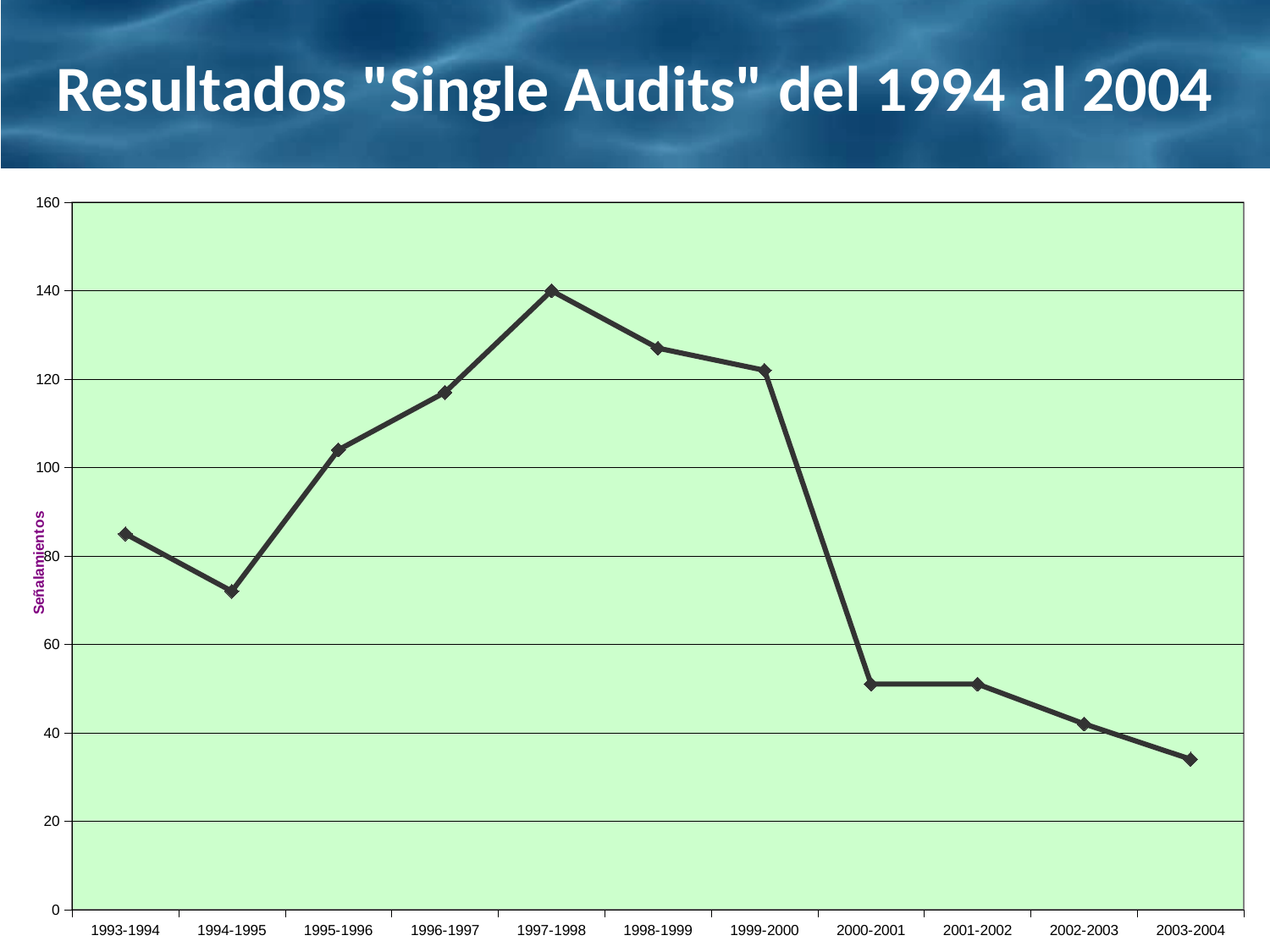
Which is larger, the value for 1998-1999 or the value for 1999-2000? 1998-1999 What is the value for 1997-1998? 140 Is the value for 1996-1997 greater or less than 100? greater What is the label on the vertical axis? Señalamientos Is the value for 1993-1994 greater or less than 80? greater Which period has the highest number of señalamientos? 1997-1998 Do the values rise or fall from 1999-2000 to 2003-2004? fall How many periods are plotted along the x axis? 11 Is the value for 2000-2001 greater or less than 60? less Which period has the lowest number of señalamientos? 2003-2004 What kind of chart is shown on the slide? line chart